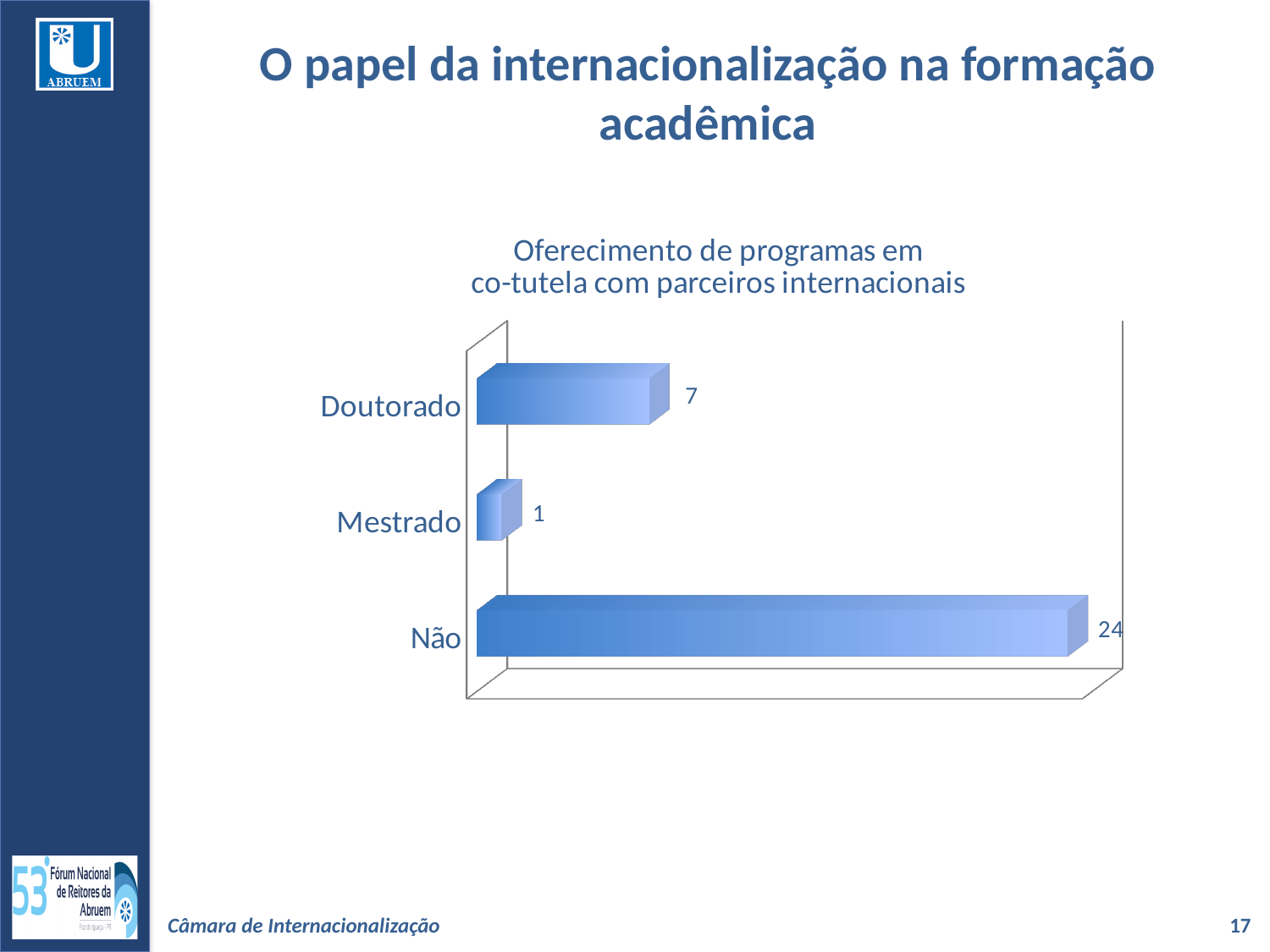
Which category has the lowest value? Mestrado How many categories are shown in the chart? 3 What is the difference between the values for Não and Doutorado? 17 Which category has the highest value? Não What is the value for Mestrado? 1 What is the value for Doutorado? 7 What is the title of the chart? Oferecimento de programas em co-tutela com parceiros internacionais What is the difference between the values for Doutorado and Mestrado? 6 What is the total of the values for Doutorado, Mestrado and Não? 32 Which is larger, the value for Doutorado or the value for Mestrado? Doutorado What is the value for Não? 24 What kind of chart is shown on the slide? bar chart